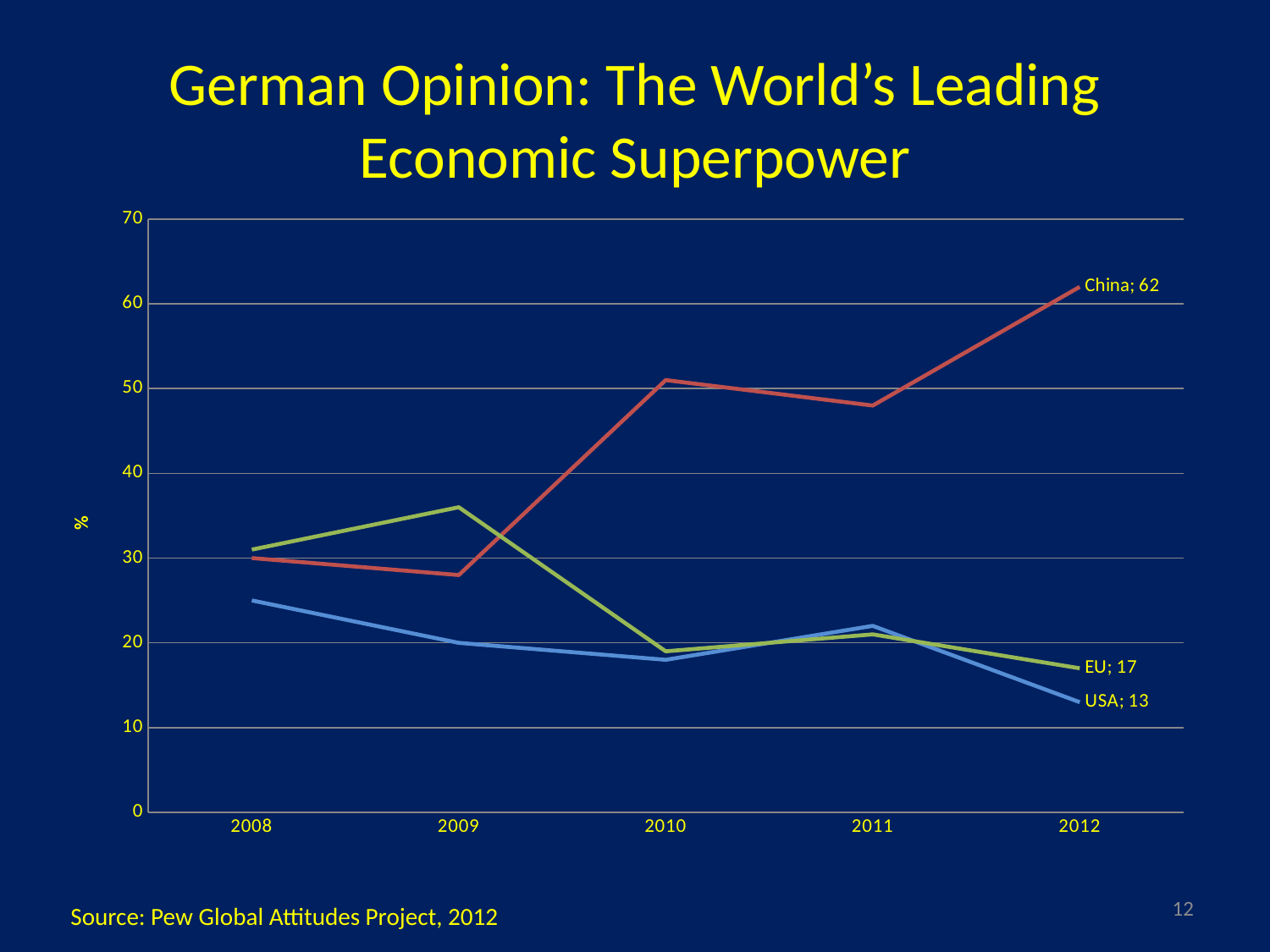
Does the USA line rise or fall from 2008 to 2012? Fall How many years are shown on the x axis? 5 Is the value for the EU in 2009 greater or less than 30? greater What kind of chart is shown on the slide? Line chart What is the value for the USA in 2012? 13 What is the value for the EU in 2012? 17 What is the difference between the China and USA values in 2012? 49 Is the value for China in 2009 greater or less than 30? less How many series (lines) are plotted on the chart? 3 What is the value for China in 2012? 62 Which series has the highest value in 2012? China Which series has the lowest value in 2012? USA